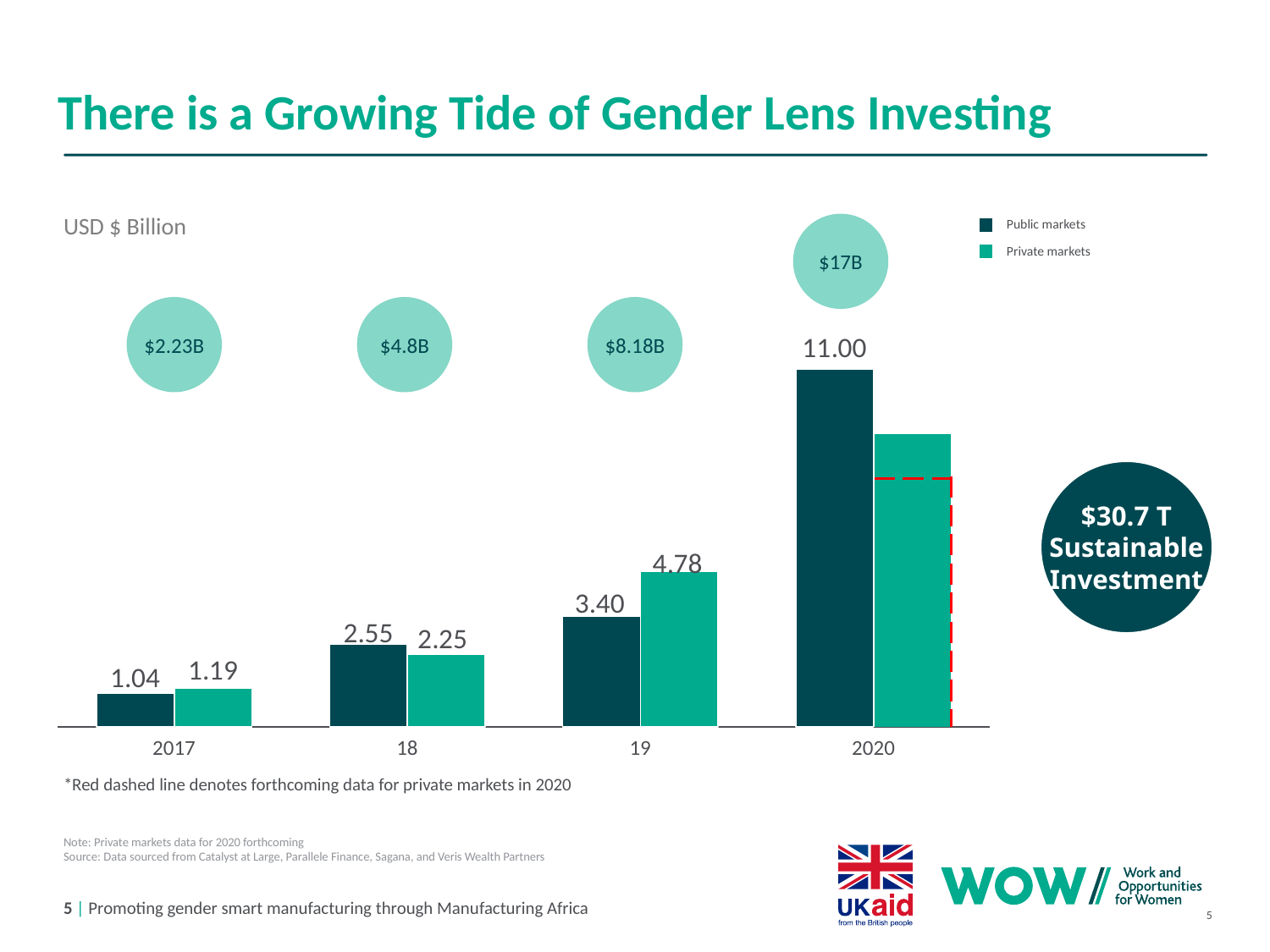
How many series does the legend list? 2 Do the Public markets values rise or fall from 2017 to 2020? Rise What is the value for Private markets in 18? 2.25 How many years are shown on the x axis? 4 Which year has the lowest Private markets value? 2017 Which year has the highest Public markets value? 2020 In 18, which is larger: Public markets or Private markets? Public markets What is the difference between the Private markets and Public markets values in 19? 1.38 What is the value for Public markets in 2020? 11.00 What is the value for Public markets in 2017? 1.04 What is the value for Private markets in 19? 4.78 What kind of chart is shown on the slide? Bar chart